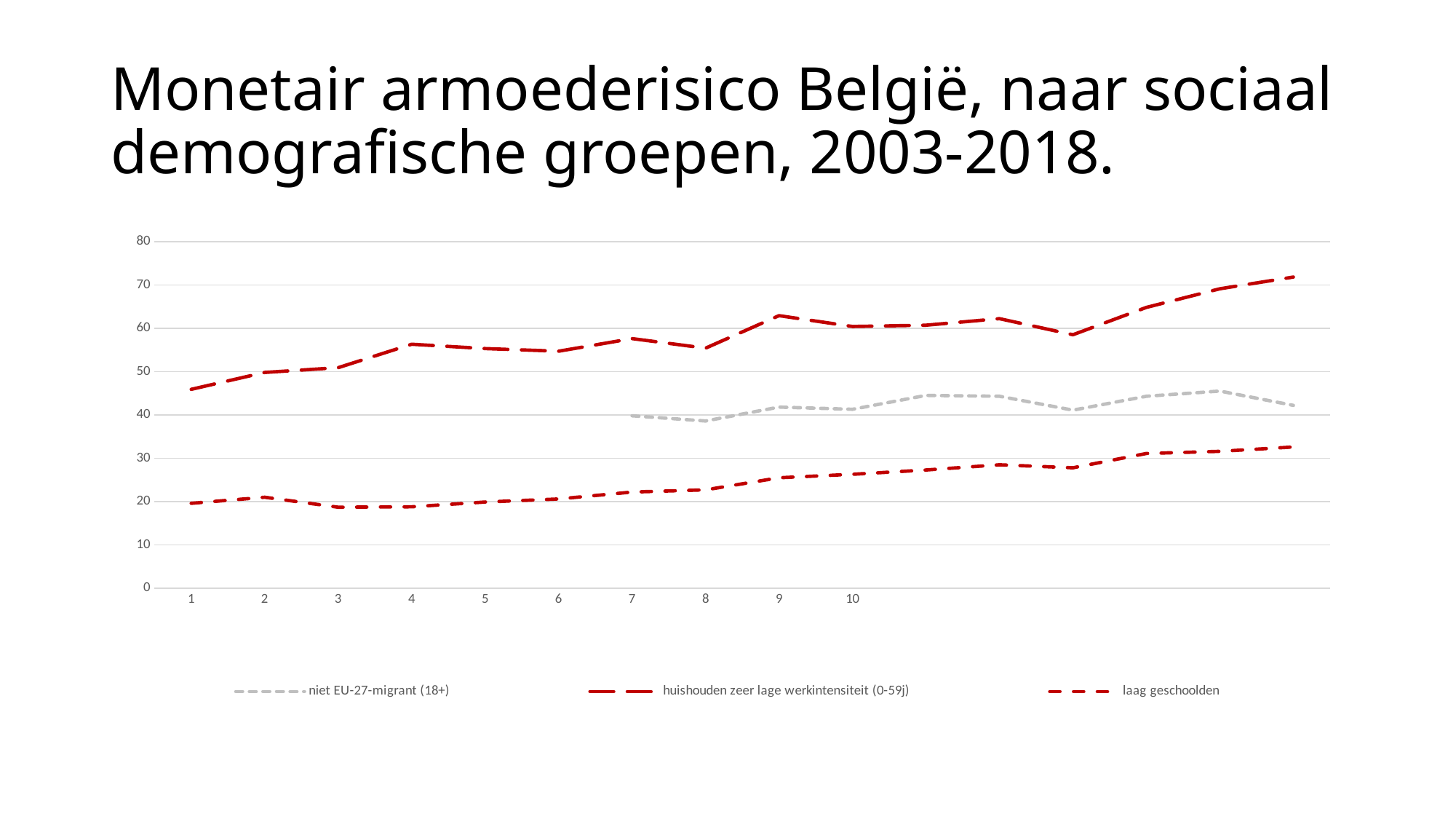
At point 7, which series has the larger value: 'huishouden zeer lage werkintensiteit (0-59j)' or 'niet EU-27-migrant (18+)'? huishouden zeer lage werkintensiteit (0-59j) Is the value for 'niet EU-27-migrant (18+)' at point 8 greater or less than 40? less Is the value for 'huishouden zeer lage werkintensiteit (0-59j)' at point 1 greater or less than 40? greater What is the title of the chart on the slide? Monetair armoederisico België, naar sociaal demografische groepen, 2003-2018. What kind of chart is shown on the slide? line chart Which series has the lowest values across the whole chart? laag geschoolden Is the value for 'huishouden zeer lage werkintensiteit (0-59j)' at point 9 greater or less than 60? greater Does the 'laag geschoolden' series generally rise or fall from left to right? rise Which series is drawn with a grey dotted line? niet EU-27-migrant (18+) How many series does the legend list? 3